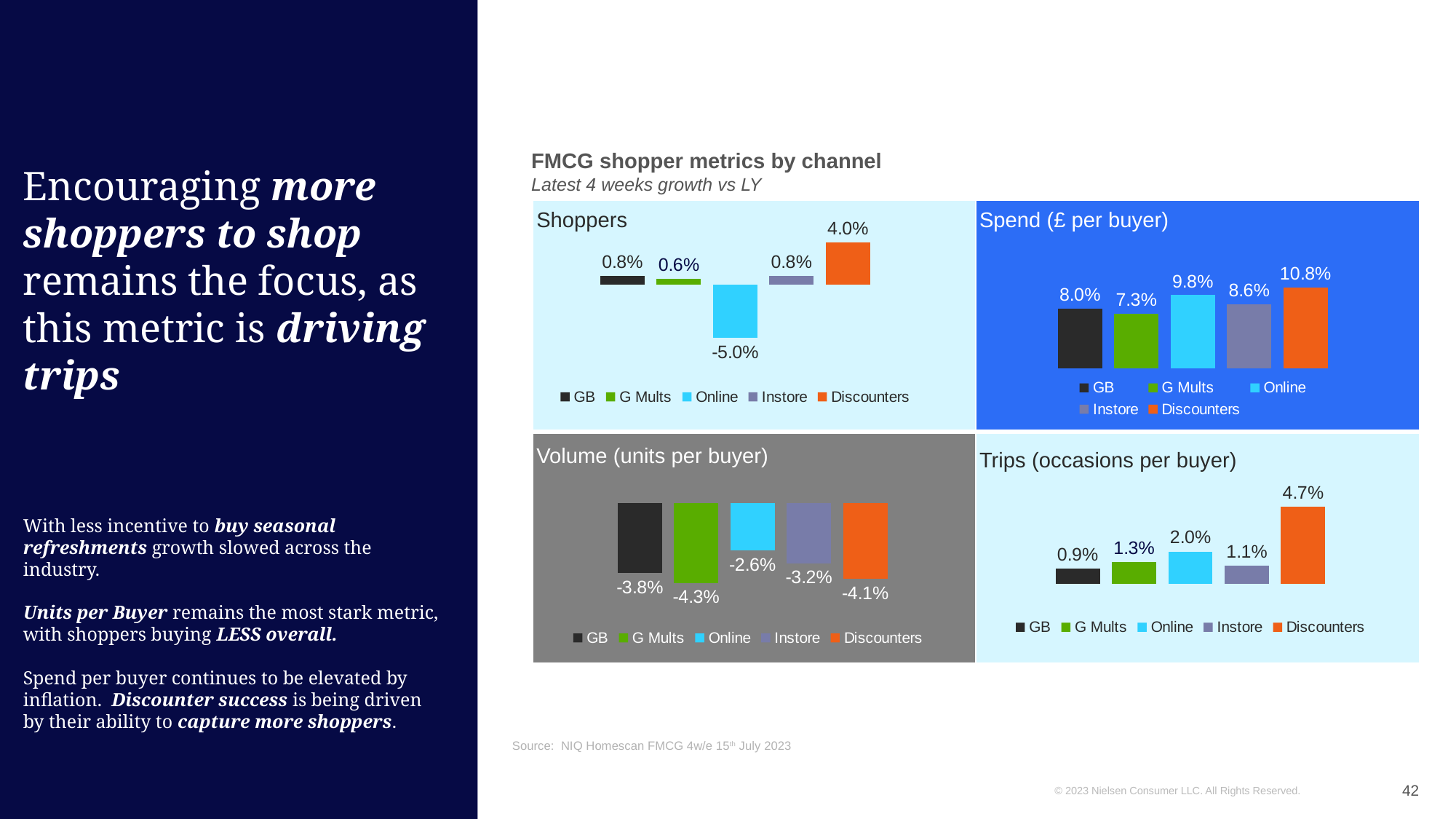
In the Trips (occasions per buyer) chart, what is the value for Discounters? 4.7% What is the title of the group of charts on the slide? FMCG shopper metrics by channel In the Shoppers chart, which channel has the highest value? Discounters In the Shoppers chart, what is the value for Online? -5.0% In the Spend (£ per buyer) chart, what is the difference between Discounters and GB? 2.8% In the Volume (units per buyer) chart, which channel has the lowest value? G Mults In the Volume (units per buyer) chart, what is the value for Instore? -3.2% What kind of chart is the Volume (units per buyer) chart? Bar chart In the Trips (occasions per buyer) chart, which is larger, Online or Instore? Online In the Spend (£ per buyer) chart, which channel has the lowest value? G Mults In the Spend (£ per buyer) chart, what is the value for Online? 9.8% How many series does the legend of the Trips (occasions per buyer) chart list? 5